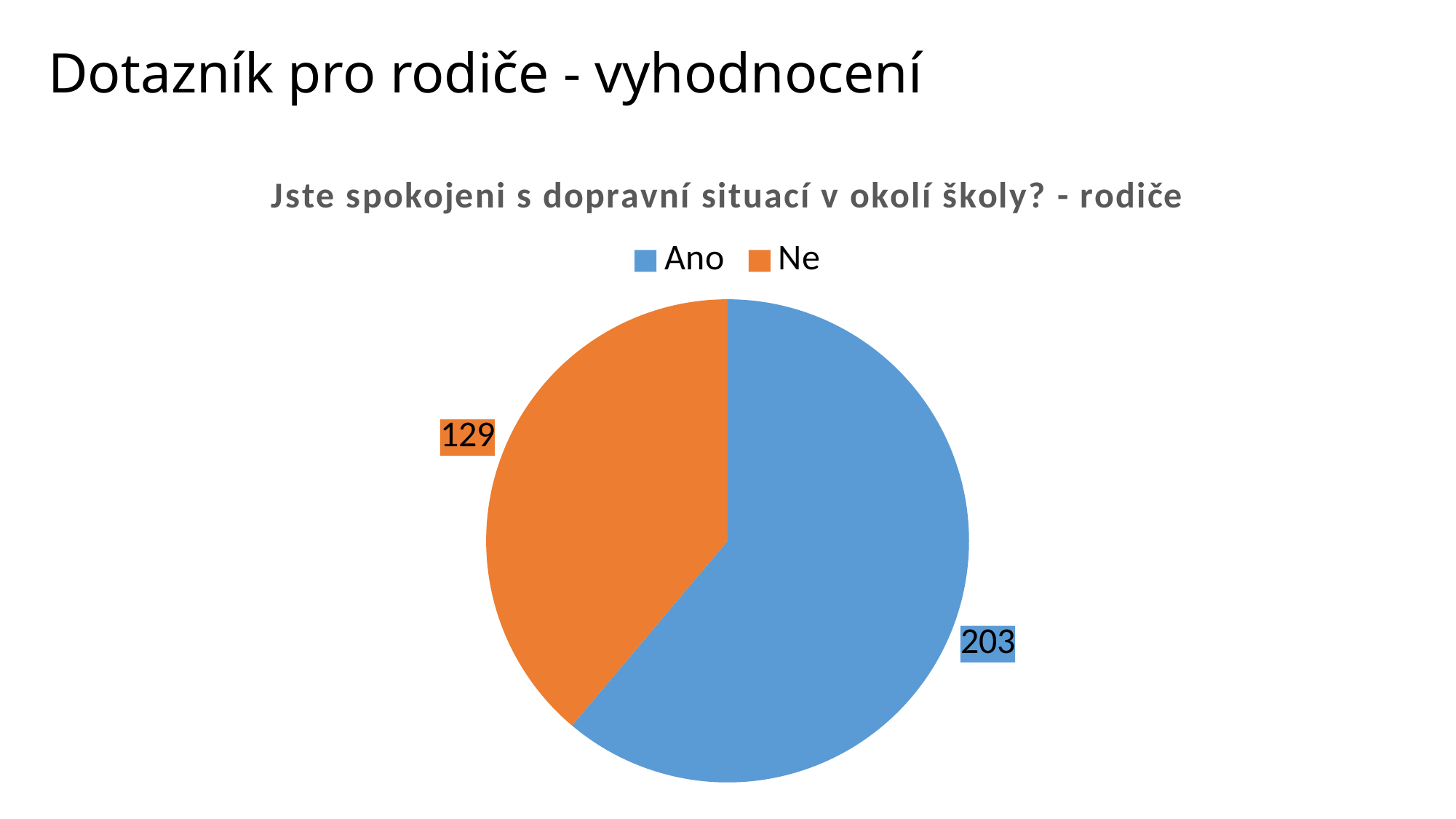
How many slices does the pie chart have? 2 What is the total of all slices in the pie chart? 332 What colour is the Ne slice? orange Which category has the smallest slice? Ne What is the value for Ano? 203 What is the difference between the values for Ano and Ne? 74 How many entries does the legend list? 2 What kind of chart is shown on the slide? pie chart What is the title of the chart? Jste spokojeni s dopravní situací v okolí školy? - rodiče What is the value for Ne? 129 Which category has the largest slice? Ano Which is larger, Ano or Ne? Ano